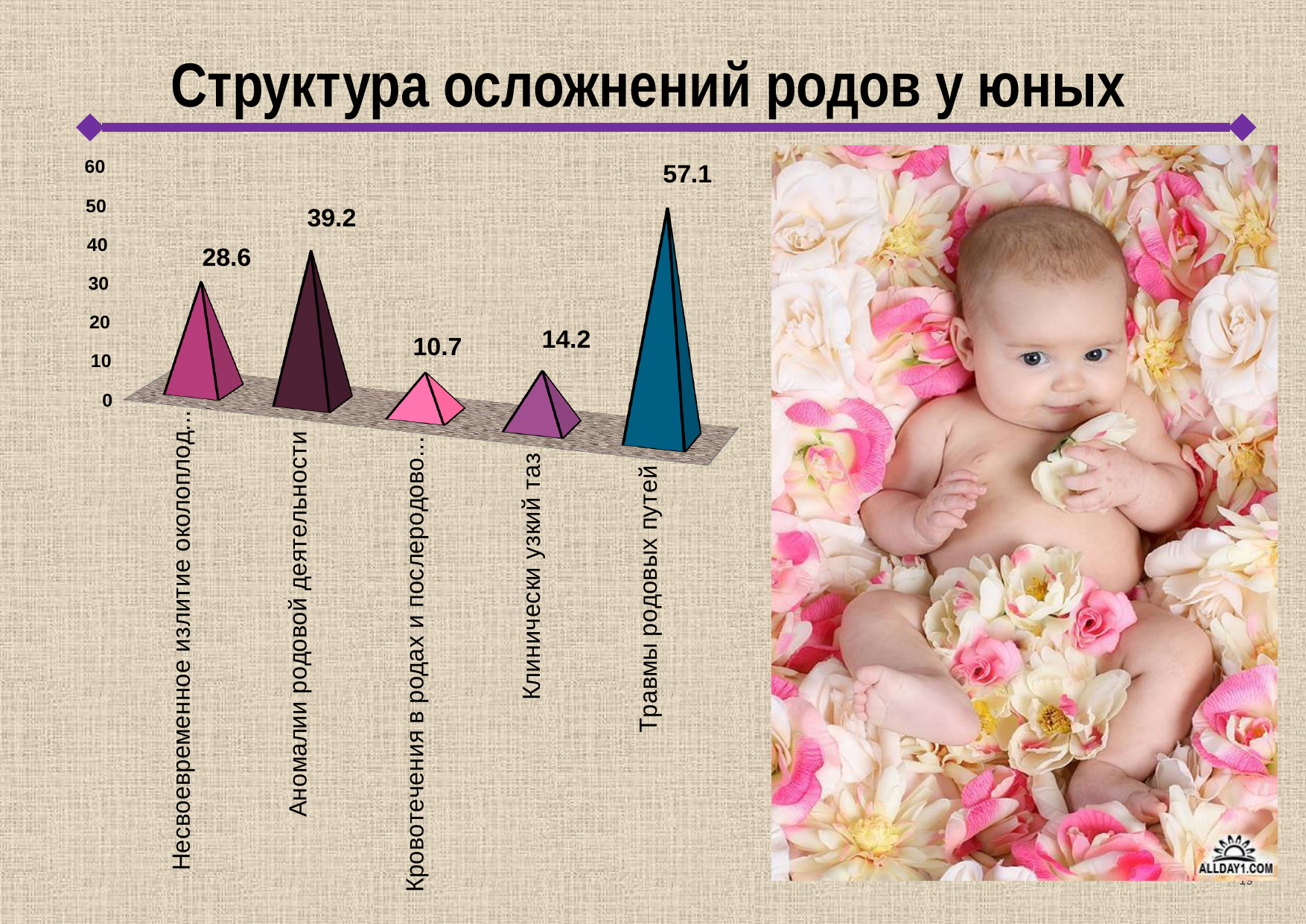
Which is larger: the value for Клинически узкий таз or the value for Кровотечения в родах и послеродово...? Клинически узкий таз What kind of chart is shown on the slide? bar chart What value is shown for the first category on the left (Несвоевременное излитие околоплод...)? 28.6 What is the difference between the values for Травмы родовых путей and Аномалии родовой деятельности? 17.9 Which category has the lowest value? Кровотечения в родах и послеродово... Which category has the highest value? Травмы родовых путей What value is shown for Травмы родовых путей? 57.1 What value is shown for Клинически узкий таз? 14.2 How many categories are shown in the chart? 5 What is the title of the slide? Структура осложнений родов у юных What value is shown for Аномалии родовой деятельности? 39.2 Is the value for Аномалии родовой деятельности greater or less than 30? greater